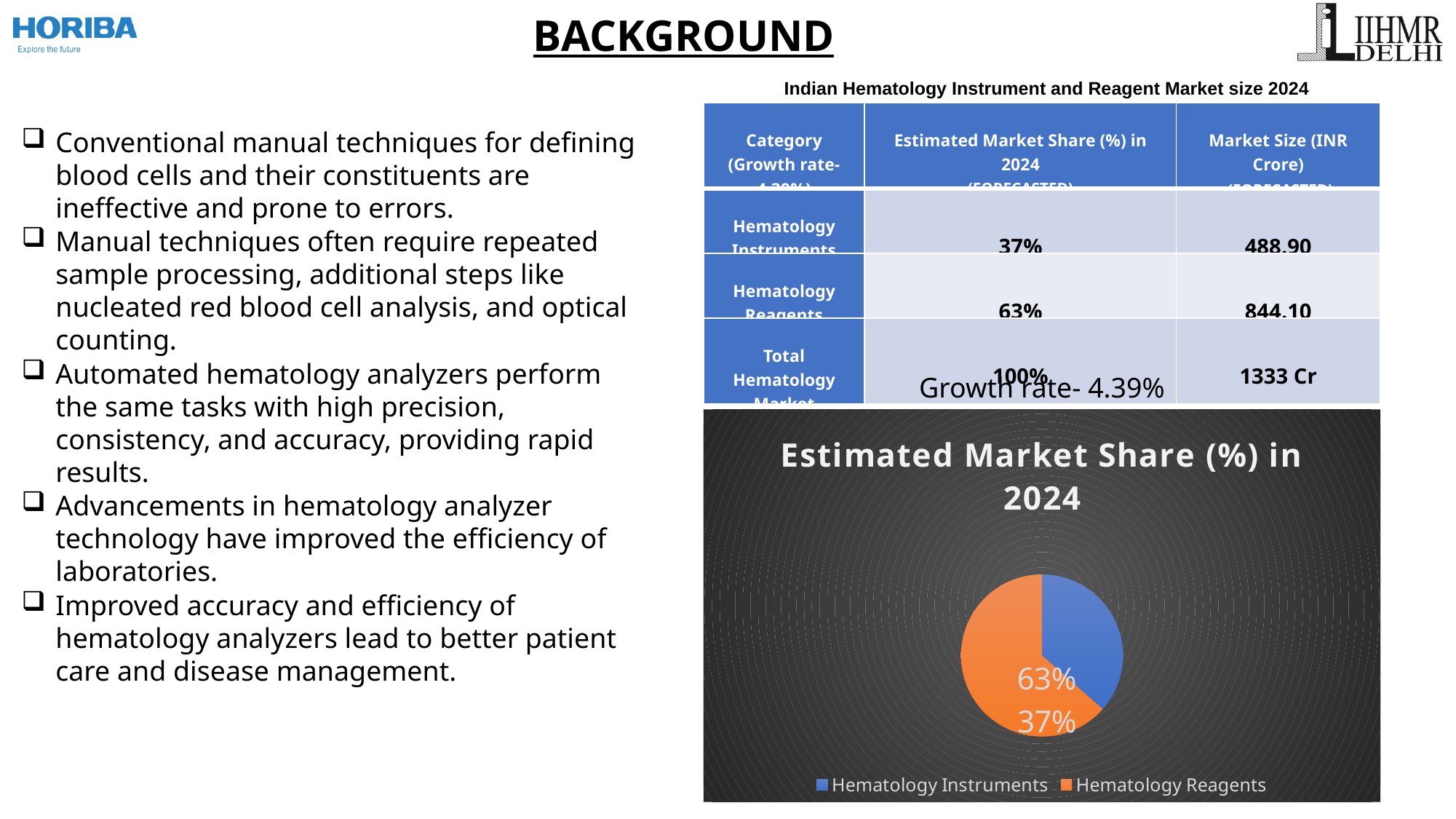
By how many percentage points does the Hematology Reagents share exceed the Hematology Instruments share in the pie chart? 26 Which is larger in the pie chart, the share for Hematology Instruments or for Hematology Reagents? Hematology Reagents What is the title of the pie chart? Estimated Market Share (%) in 2024 What kind of chart is shown on the slide? pie chart How many entries does the pie chart's legend list? 2 What share of the pie does the Hematology Instruments slice represent? 37% What is the estimated market share for Hematology Reagents in the pie chart? 63% Which colour represents Hematology Reagents in the pie chart? orange Which category has the smallest slice in the pie chart? Hematology Instruments Which category has the largest slice in the pie chart? Hematology Reagents How many slices does the pie chart have? 2 What is the estimated market share for Hematology Instruments in the pie chart? 37%